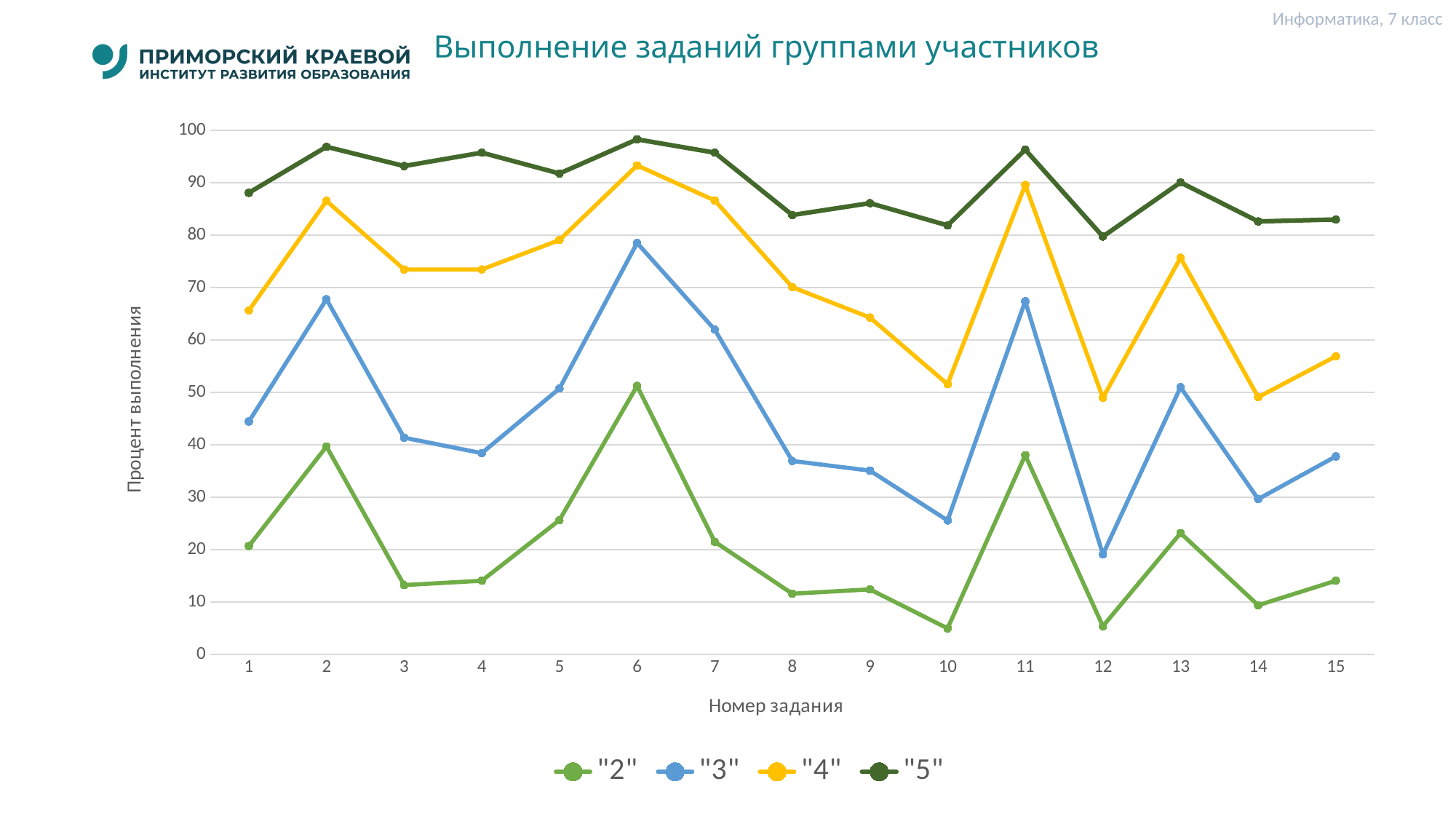
For series "3", which task has the larger value: task 7 or task 13? task 7 Does the series "2" rise or fall from task 6 to task 10? fall Is the value of series "3" for task 6 greater or less than 70? greater What is the title of the vertical axis? Процент выполнения How many series does the legend list? 4 Is the value of series "4" for task 10 greater or less than 60? less What kind of chart is shown on the slide? line chart For which task number does the series "3" have its lowest value? 12 For which task number does the series "3" reach its highest value? 6 Is the value of series "5" for task 8 greater or less than 90? less How many task numbers are plotted along the x axis? 15 For which task number does the series "2" reach its highest value? 6